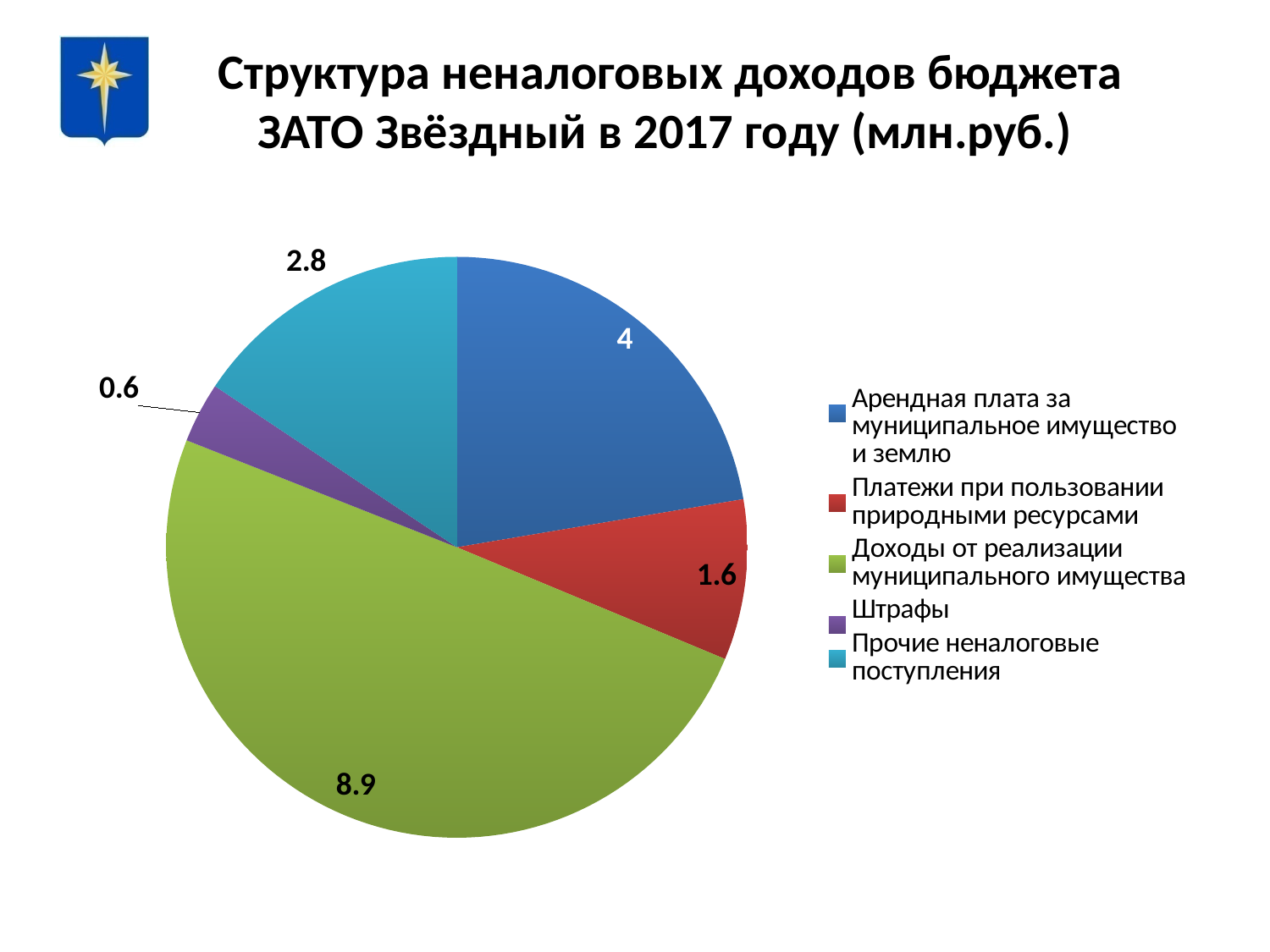
How many categories does the pie chart show? 5 What is the value for Арендная плата за муниципальное имущество и землю? 4 What is the value for Прочие неналоговые поступления? 2.8 Which is larger: Прочие неналоговые поступления or Платежи при пользовании природными ресурсами? Прочие неналоговые поступления Which category has the smallest slice of the pie? Штрафы Which category has the largest slice of the pie? Доходы от реализации муниципального имущества What is the value for Доходы от реализации муниципального имущества? 8.9 What is the value for Платежи при пользовании природными ресурсами? 1.6 What is the value for Штрафы? 0.6 What is the total of all slices in the pie chart? 17.9 What kind of chart is shown on the slide? Pie chart What is the difference between the values for Доходы от реализации муниципального имущества and Арендная плата за муниципальное имущество и землю? 4.9